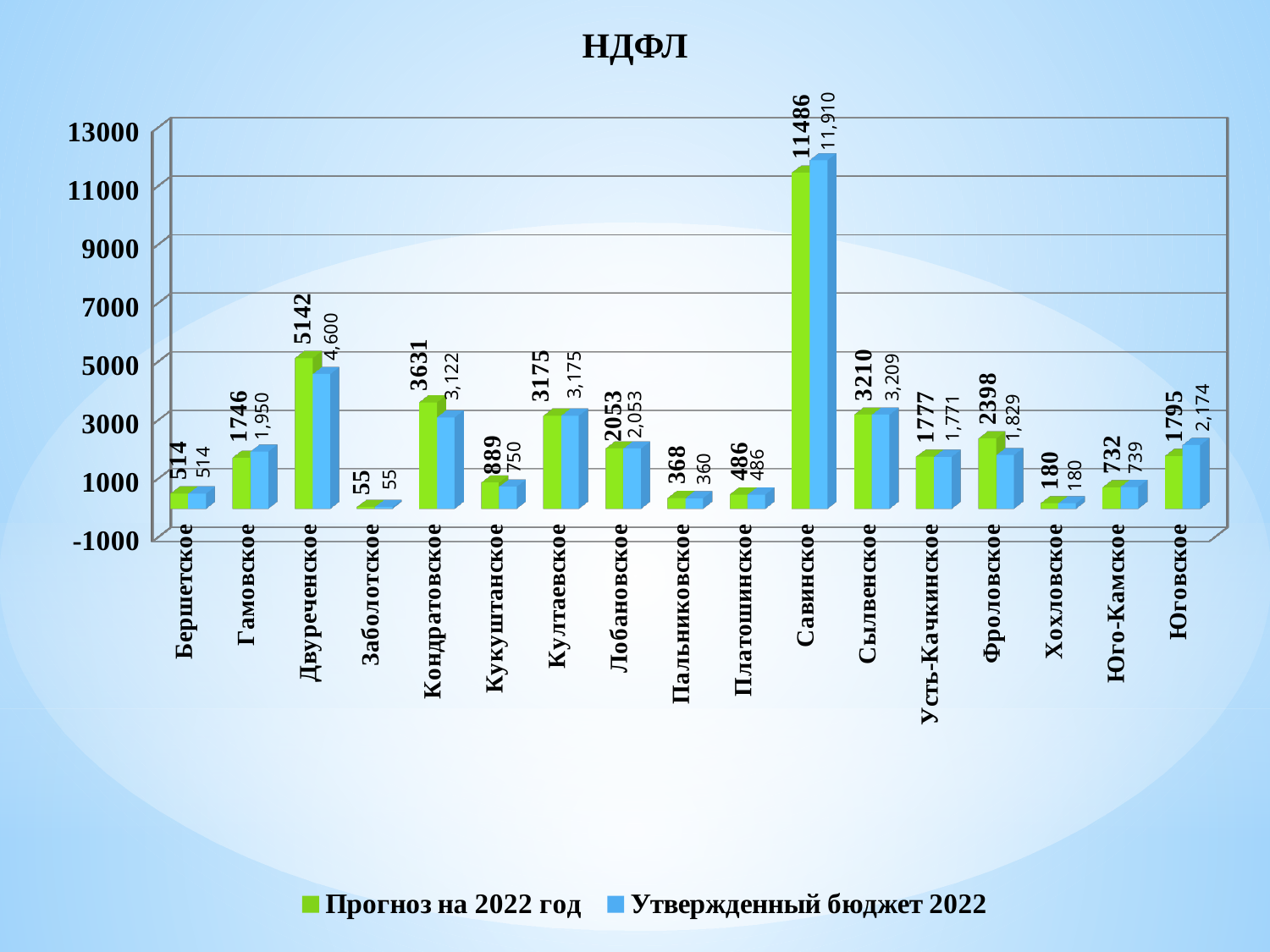
Which category has the highest forecast value (Прогноз на 2022 год)? Савинское What is the title of the chart? НДФЛ How many categories are shown on the x axis? 17 What is the approved budget value (Утвержденный бюджет 2022) for Фроловское? 1,829 Which category has the lowest forecast value (Прогноз на 2022 год)? Заболотское Is the forecast value for Сылвенское greater or less than 3000? greater How many series does the legend list? 2 What is the forecast value (Прогноз на 2022 год) for Двуреченское? 5142 For Юговское, which is larger: the forecast or the approved budget? Утвержденный бюджет 2022 What is the approved budget value (Утвержденный бюджет 2022) for Савинское? 11,910 What is the difference between the forecast and the approved budget for Кондратовское? 509 What kind of chart is shown on the slide? Bar chart